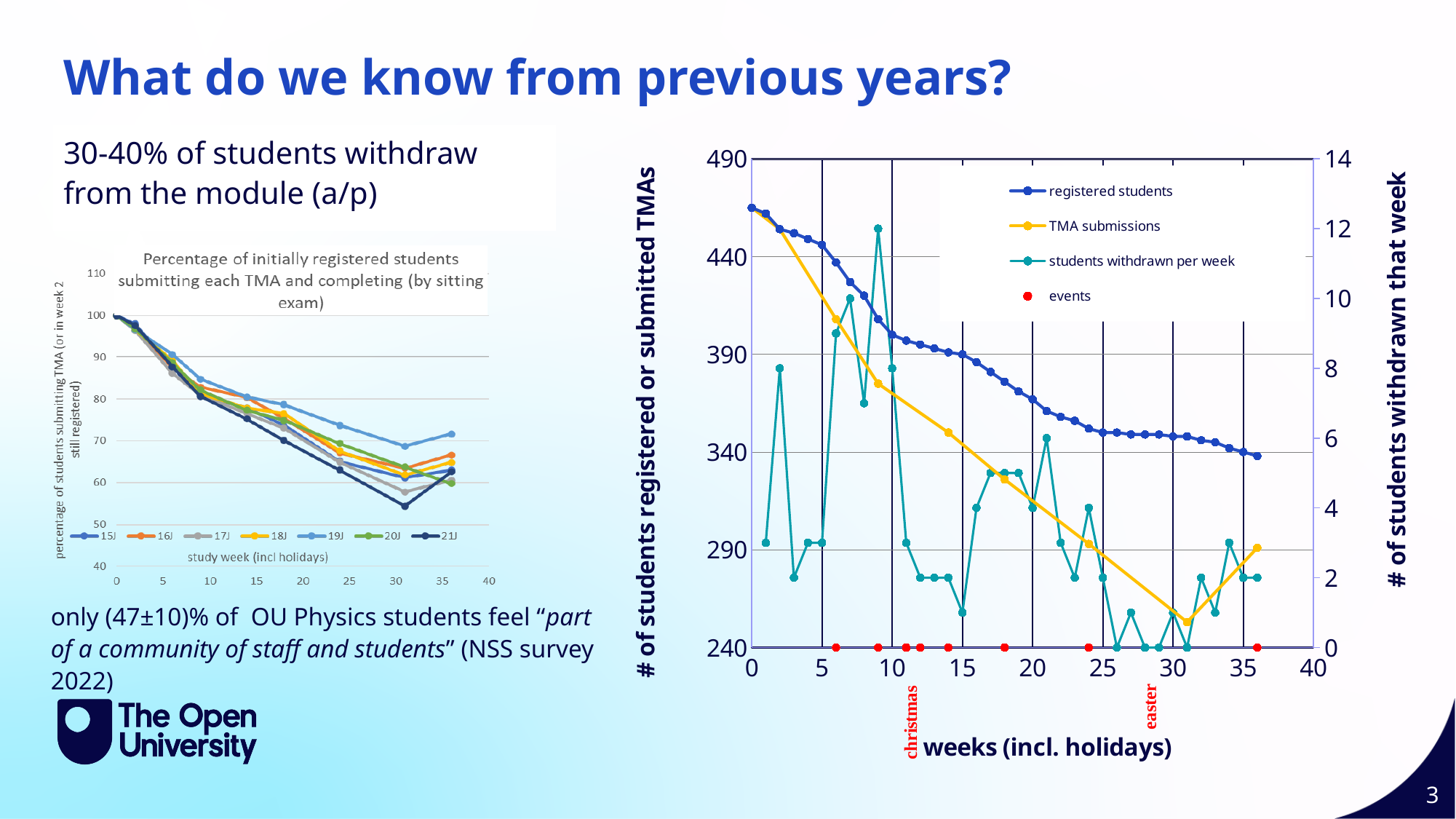
In the right chart, does the number of registered students rise or fall over the weeks? fall What kind of chart is the chart on the left of the slide? line chart In the right chart, is the number of registered students at week 20 greater or less than 340? greater How many series does the legend of the left chart list? 7 How many entries does the legend of the right chart list? 4 In the right chart, is the peak number of students withdrawn per week (at week 9) greater or less than 10? greater In the left chart, is the value for 21J at about study week 31 greater or less than 60? less In the left chart, do the values generally rise or fall from study week 0 to study week 30? fall In the left chart, which series has the highest value around study week 31? 19J In the left chart, which series has the lowest value around study week 31? 21J In the right chart, which two events are labelled in red along the x axis? christmas and easter In the left chart, what is the value of every series at study week 0? 100